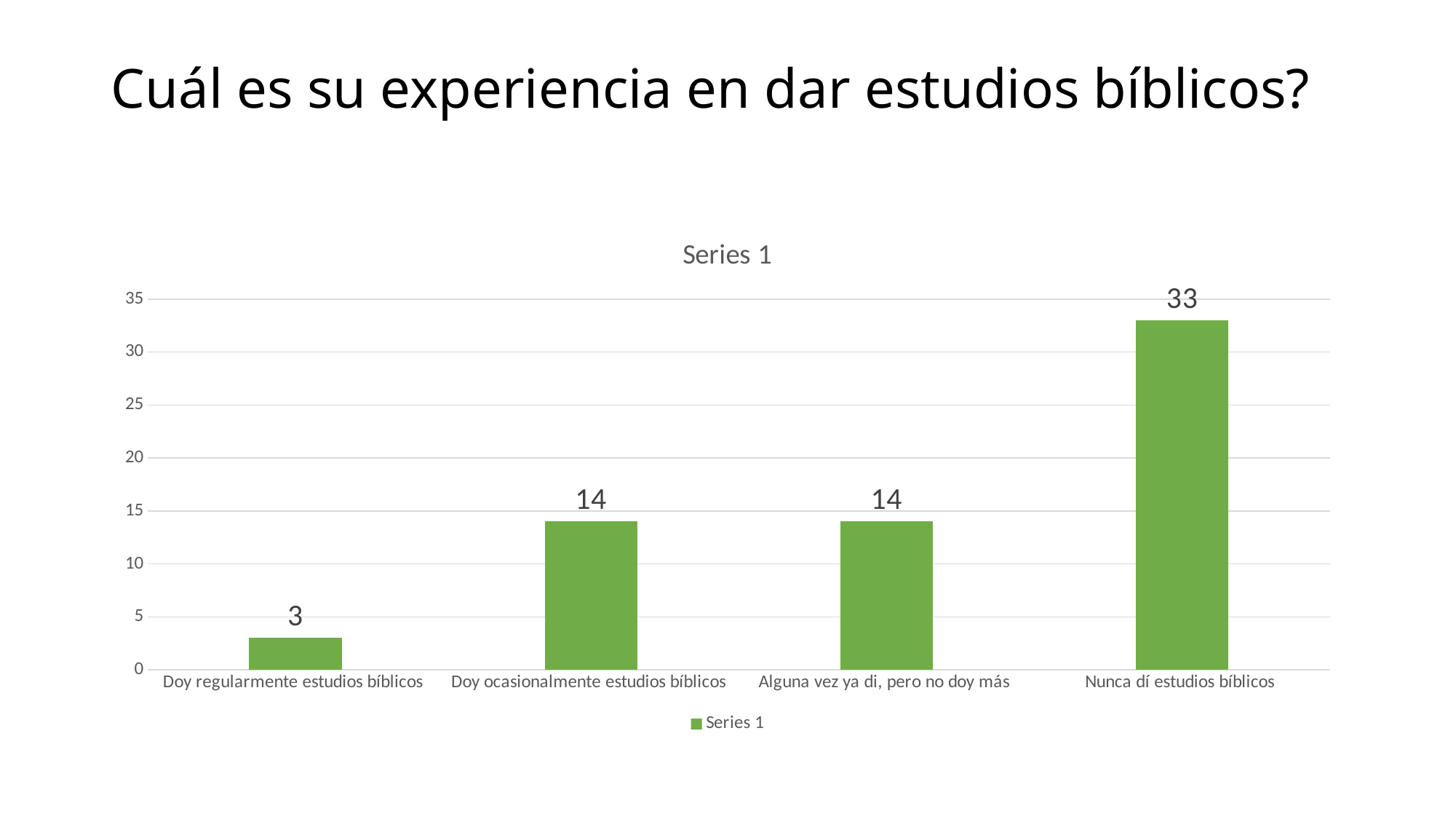
Which category has the lowest value? Doy regularmente estudios bíblicos What is the value for "Doy regularmente estudios bíblicos"? 3 What is the value for "Nunca dí estudios bíblicos"? 33 How many categories are shown on the x axis? 4 What is the difference between the values for "Nunca dí estudios bíblicos" and "Doy ocasionalmente estudios bíblicos"? 19 What is the value for "Doy ocasionalmente estudios bíblicos"? 14 Which category has the highest value? Nunca dí estudios bíblicos Is the value for "Nunca dí estudios bíblicos" greater or less than 30? greater What is the difference between the values for "Alguna vez ya di, pero no doy más" and "Doy regularmente estudios bíblicos"? 11 What kind of chart is shown on the slide? bar chart Which is larger, the value for "Nunca dí estudios bíblicos" or the value for "Alguna vez ya di, pero no doy más"? Nunca dí estudios bíblicos What is the title of the chart? Series 1